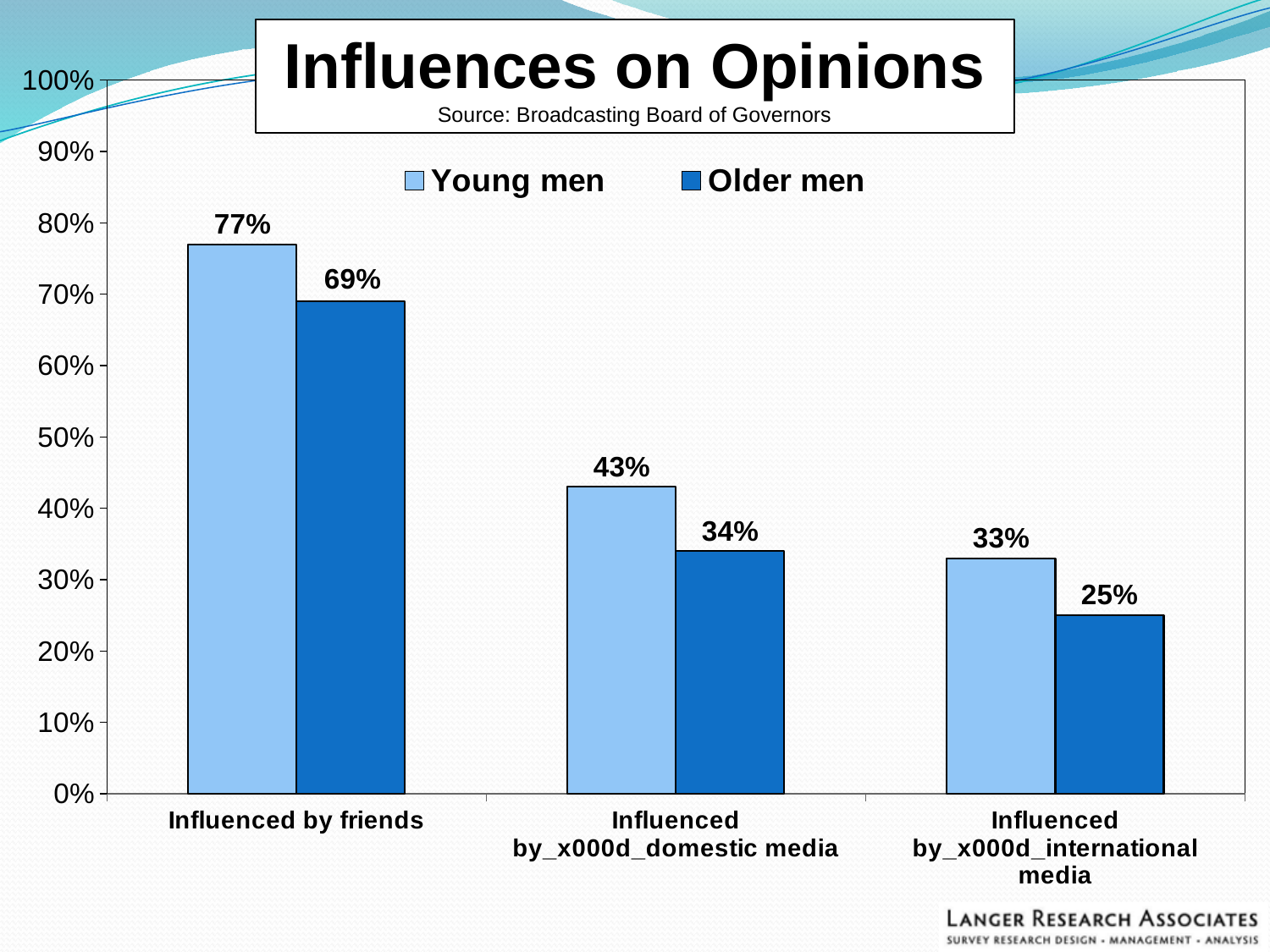
What percentage of older men are influenced by international media? 25% How many series does the legend list? 2 What percentage of young men are influenced by friends? 77% How many categories are shown on the x axis? 3 What is the title of the chart? Influences on Opinions What is the difference between young men and older men for 'Influenced by friends'? 8% Which category has the lowest value for older men? Influenced by international media What kind of chart is shown on the slide? Bar chart Which is larger: young men influenced by international media or older men influenced by domestic media? Older men influenced by domestic media What percentage of older men are influenced by domestic media? 34% Which category has the highest value for young men? Influenced by friends What is the difference between young men and older men for 'Influenced by domestic media'? 9%